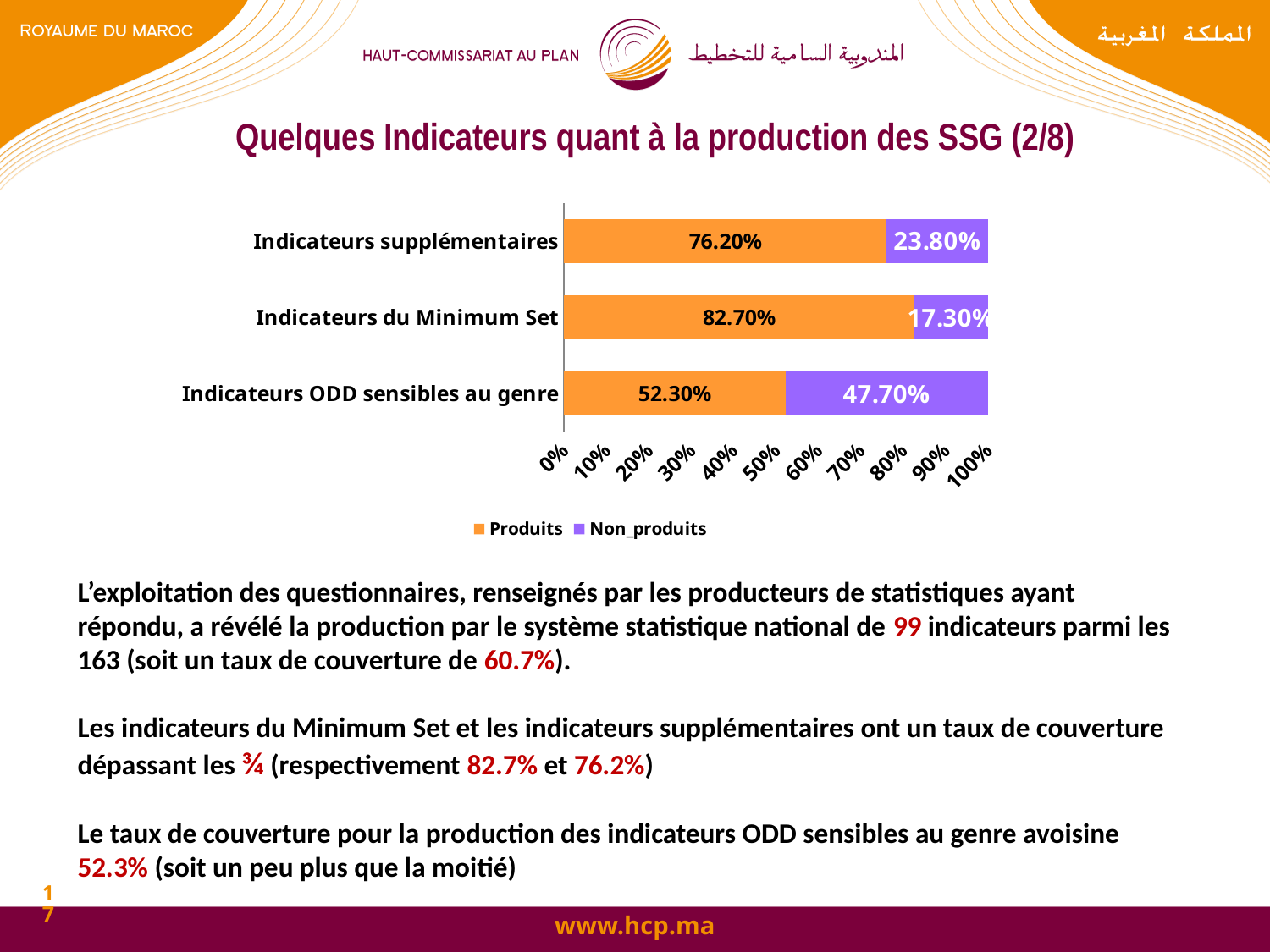
What is the 'Produits' value for 'Indicateurs supplémentaires'? 76.20% Which category has the lowest 'Produits' value? Indicateurs ODD sensibles au genre How many categories are shown on the chart? 3 What is the difference between the 'Produits' values for 'Indicateurs du Minimum Set' and 'Indicateurs supplémentaires'? 6.50% How many series does the legend list? 2 What is the 'Non_produits' value for 'Indicateurs du Minimum Set'? 17.30% What is the 'Produits' value for 'Indicateurs ODD sensibles au genre'? 52.30% What kind of chart is shown on the slide? Stacked bar chart What is the total of the stacked bar for 'Indicateurs ODD sensibles au genre'? 100.00% What is the 'Non_produits' value for 'Indicateurs ODD sensibles au genre'? 47.70% Which category has the highest 'Produits' value? Indicateurs du Minimum Set Which is larger: the 'Non_produits' value for 'Indicateurs supplémentaires' or for 'Indicateurs du Minimum Set'? Indicateurs supplémentaires